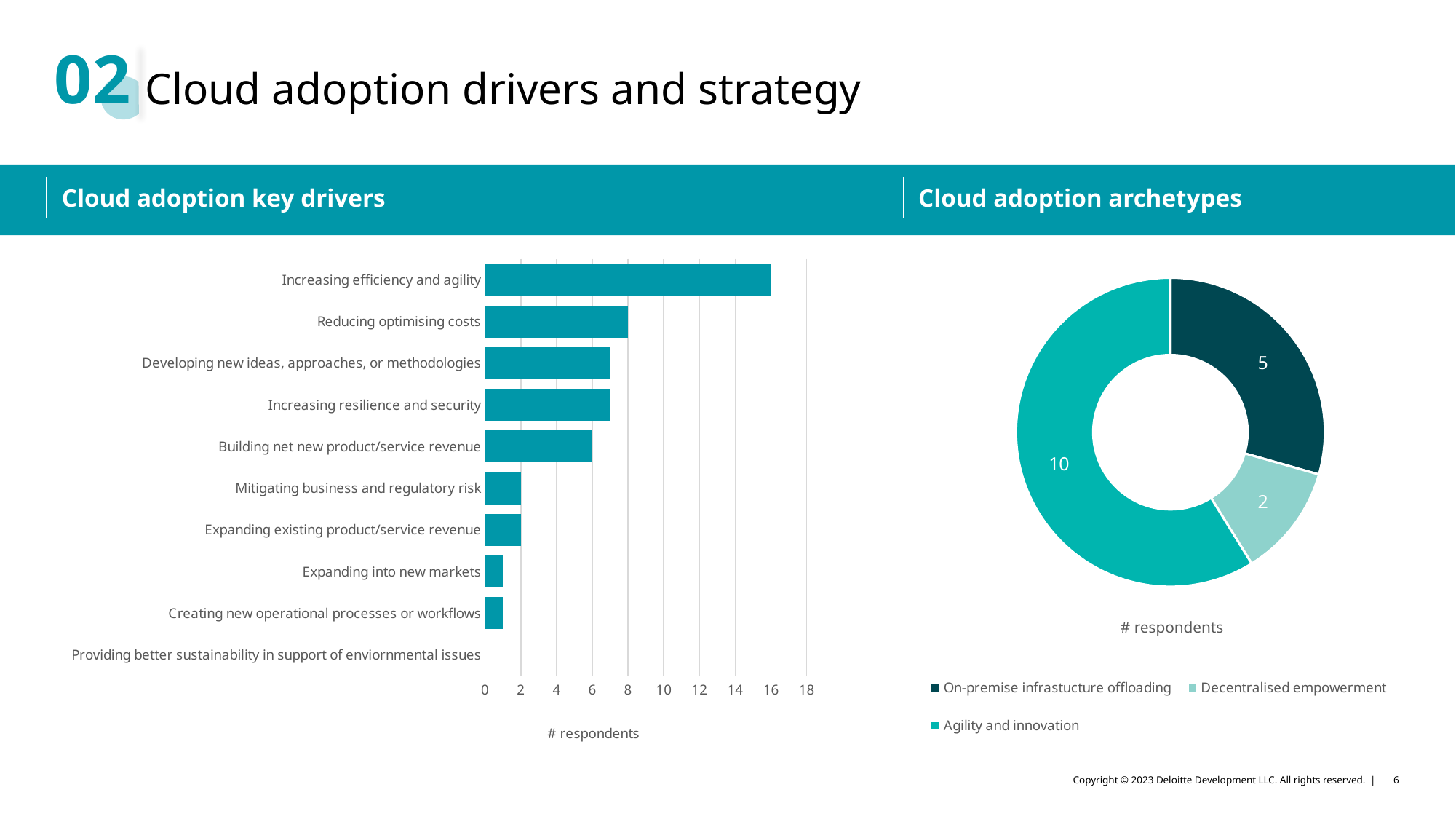
In the Cloud adoption key drivers chart, how many respondents chose Reducing optimising costs? 8 In the Cloud adoption key drivers chart, is the value for Expanding into new markets greater or less than 2? less How many entries does the legend of the Cloud adoption archetypes chart list? 3 In the Cloud adoption key drivers chart, how many respondents chose Building net new product/service revenue? 6 In the Cloud adoption archetypes chart, how many respondents fall under Agility and innovation? 10 In the Cloud adoption archetypes chart, what is the difference in respondents between Agility and innovation and On-premise infrastucture offloading? 5 In the Cloud adoption key drivers chart, which driver has the highest number of respondents? Increasing efficiency and agility In the Cloud adoption key drivers chart, is the value for Increasing resilience and security greater or less than 6? greater In the Cloud adoption key drivers chart, how many drivers are listed? 10 What type of chart is the Cloud adoption key drivers chart? Bar chart In the Cloud adoption key drivers chart, how many respondents chose Increasing efficiency and agility? 16 In the Cloud adoption key drivers chart, which driver has the lowest number of respondents? Providing better sustainability in support of enviornmental issues